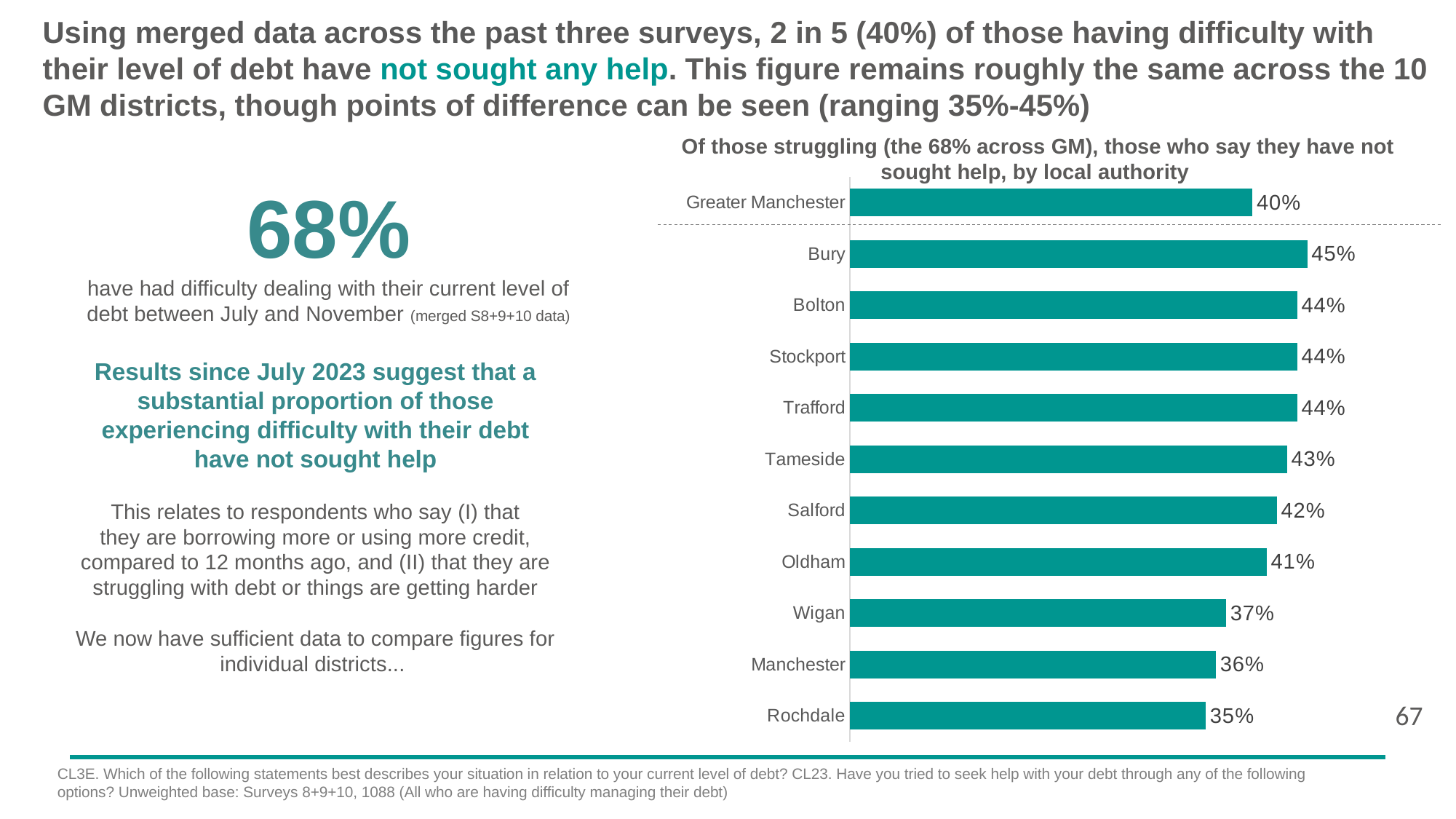
What is the value for Wigan? 37% What is the difference between the values for Bury and Rochdale? 10% What is the value for Rochdale? 35% Which local authority has the lowest value? Rochdale Which local authority has the highest value? Bury What is the title of the chart? Of those struggling (the 68% across GM), those who say they have not sought help, by local authority What kind of chart is shown on the slide? Bar chart What is the value for Bury? 45% What is the value for Greater Manchester? 40% Which is larger, the value for Tameside or the value for Oldham? Tameside How many bars are shown in the chart? 11 What is the difference between the values for Salford and Manchester? 6%